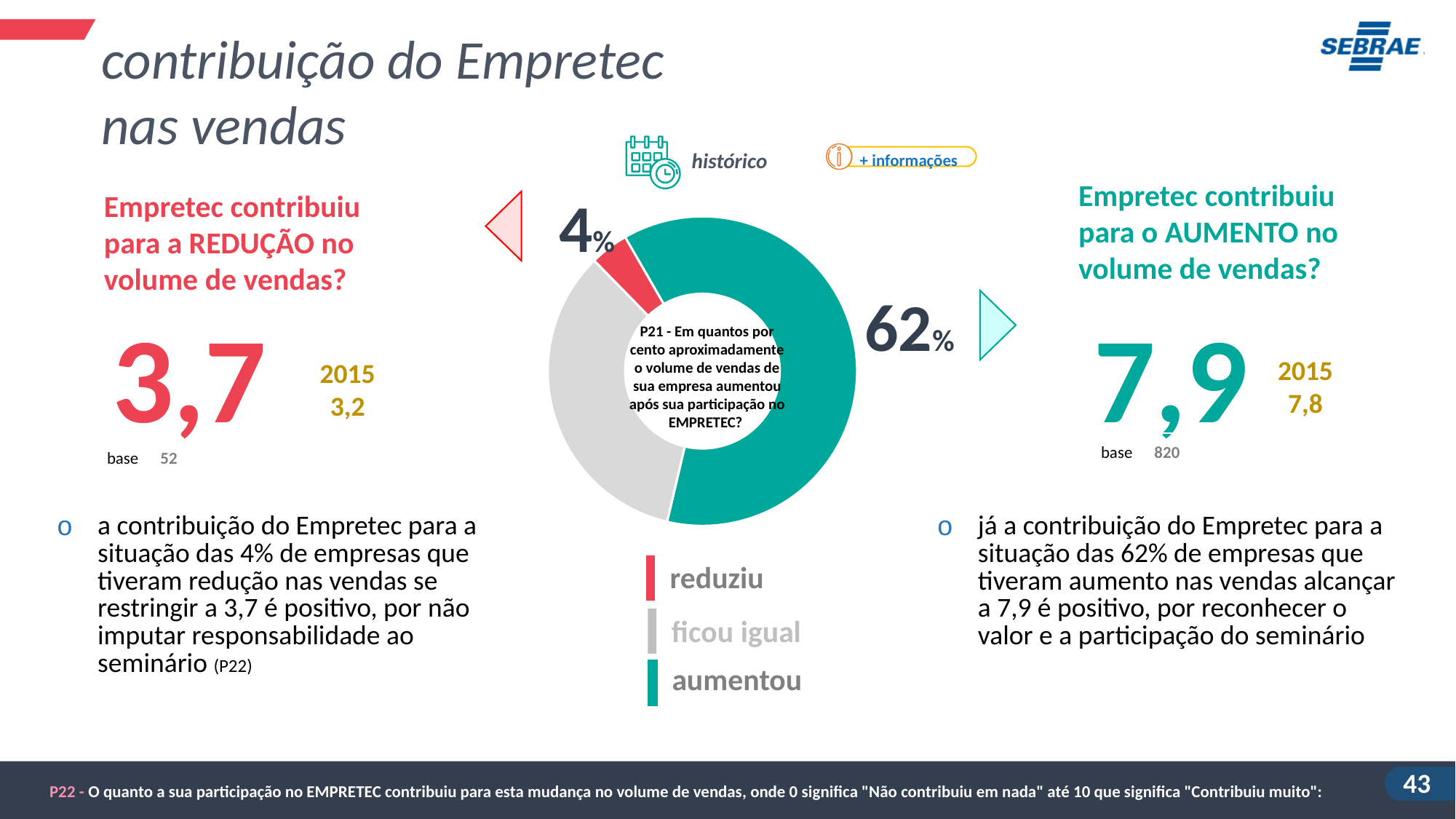
What share of the pie chart is labelled 'aumentou'? 62% Which slice is larger in the pie chart, 'ficou igual' or 'reduziu'? ficou igual Which slice is larger in the pie chart, 'aumentou' or 'reduziu'? aumentou Which category has the smallest slice in the pie chart? reduziu What kind of chart is shown in the centre of the slide? doughnut chart How many categories does the pie chart have? 3 What is the difference in percentage points between the 'aumentou' slice and the 'reduziu' slice? 58 What colour represents 'ficou igual' in the pie chart? grey How many entries does the legend of the pie chart list? 3 Which category has the largest slice in the pie chart? aumentou What share of the pie chart is labelled 'reduziu'? 4% What colour represents 'reduziu' in the pie chart? red